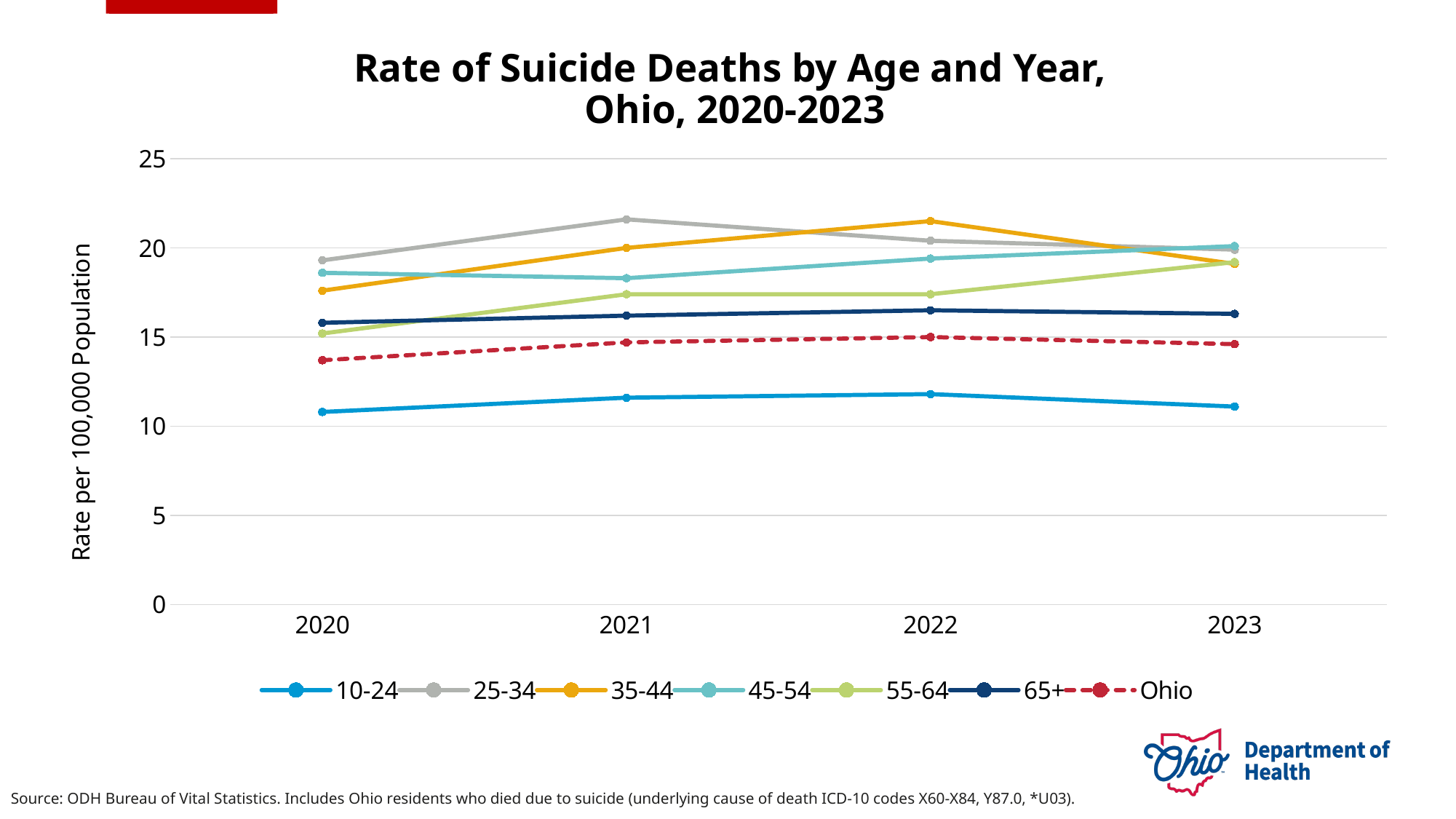
Does the rate for the 55-64 age group rise or fall from 2020 to 2023? rise Which age group has the highest suicide death rate in 2022? 35-44 Is the value for the 10-24 age group in 2020 greater or less than 15? less Which age group has the lowest suicide death rate in 2020? 10-24 What kind of chart is shown on the slide? line chart How many years are shown on the x axis? 4 Is the value for the 25-34 age group in 2021 greater or less than 20? greater Is the Ohio overall rate in 2022 greater or less than 20? less How many series does the legend list? 7 Which age group has the highest suicide death rate in 2021? 25-34 Which series is drawn with a dashed line? Ohio In 2021, which is larger: the rate for 25-34 or the rate for 35-44? 25-34